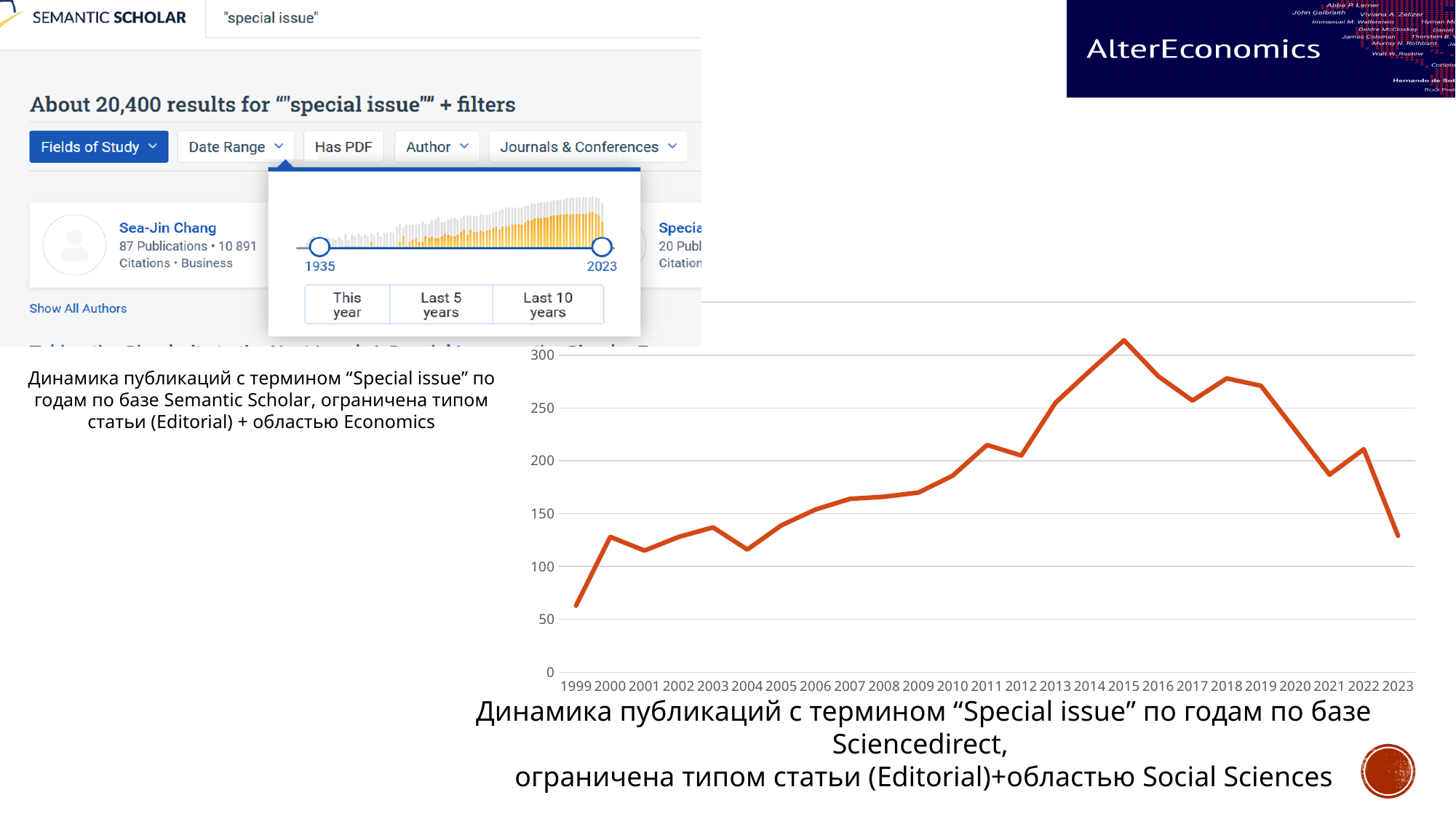
In the Sciencedirect line chart, is the value for 2014 greater or less than 250? greater In the Sciencedirect line chart, is the value for 1999 greater or less than 100? less In the Sciencedirect line chart, which year has the larger value, 2015 or 2023? 2015 In the Sciencedirect line chart, which year has the lowest value? 1999 What kind of chart is the Sciencedirect chart on the right side of the slide? line chart In the Sciencedirect line chart, which year has the highest value? 2015 In the Sciencedirect line chart, which year has the larger value, 2017 or 2018? 2018 In the Sciencedirect line chart, what is the first year shown on the x axis? 1999 In the Sciencedirect line chart, how many years are shown on the x axis? 25 In the Sciencedirect line chart, do the values generally rise or fall from 1999 to 2015? rise In the Sciencedirect line chart, is the value for 2015 greater or less than 300? greater